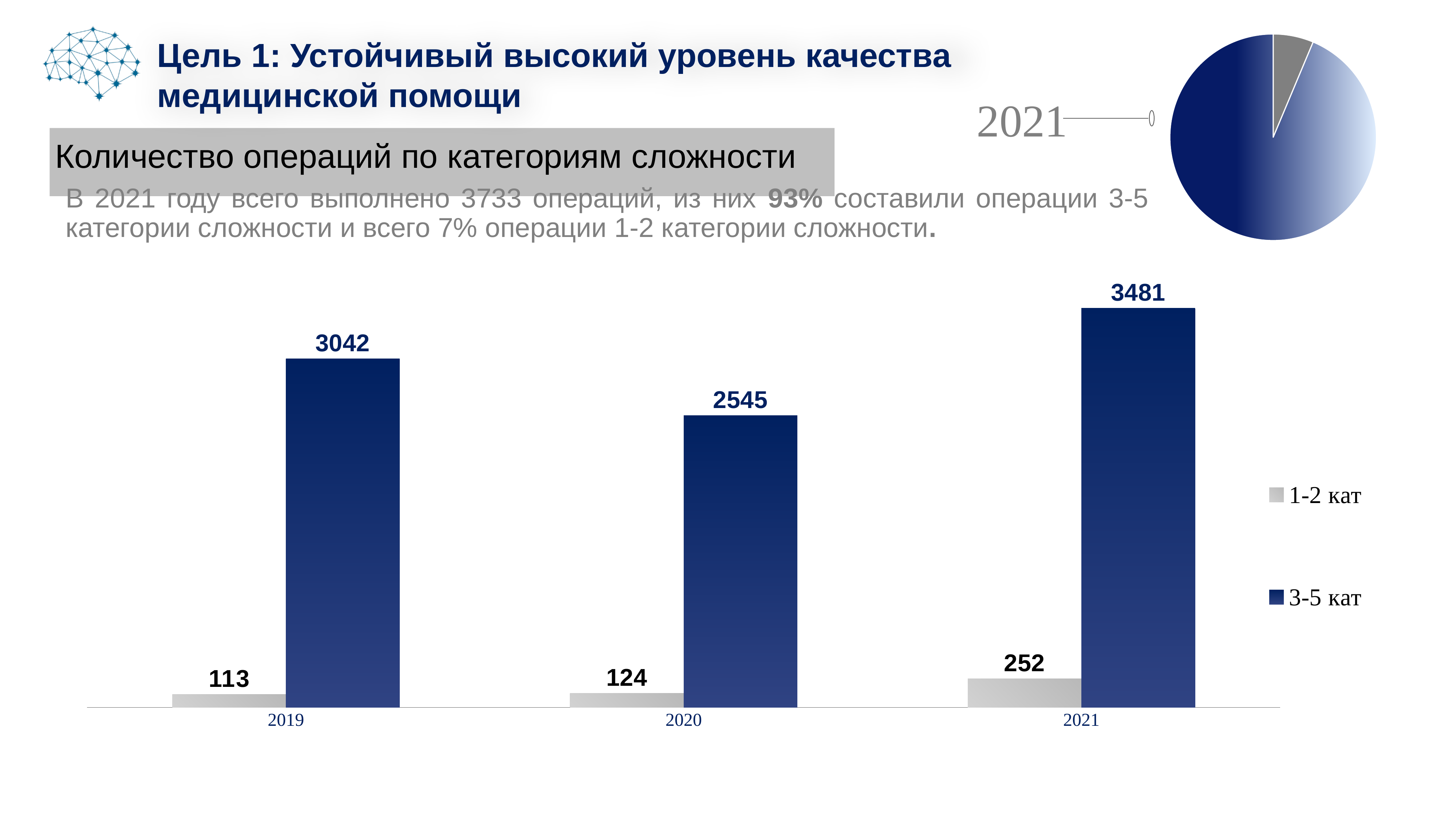
In the bar chart, what is the value for 3-5 кат in 2020? 2545 In the bar chart, which year has the highest value for 3-5 кат? 2021 In the bar chart, which year has the lowest value for 1-2 кат? 2019 In the bar chart, which is larger: the 3-5 кат value for 2019 or for 2020? 2019 In the bar chart, how many years are shown on the x axis? 3 In the bar chart, what is the difference between the 3-5 кат values for 2021 and 2020? 936 In the bar chart, how many series does the legend list? 2 In the bar chart, what is the value for 1-2 кат in 2020? 124 What kind of chart is the large chart at the bottom of the slide? bar chart In the bar chart, what is the value for 3-5 кат in 2019? 3042 In the bar chart, what is the value for 1-2 кат in 2021? 252 In the bar chart, which legend entry is shown in grey? 1-2 кат